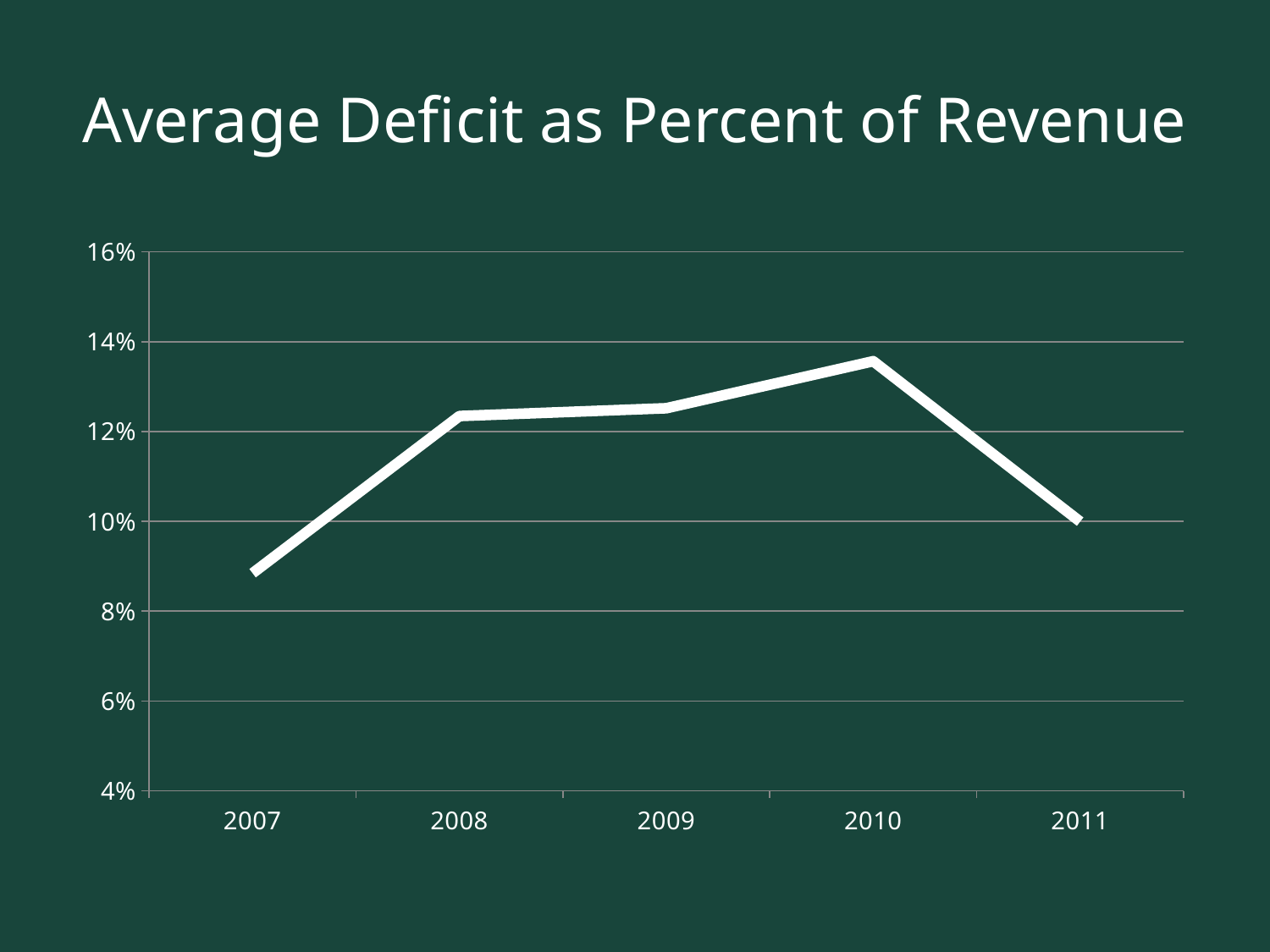
Which year has the highest average deficit as percent of revenue? 2010 How many years are plotted on the x axis? 5 What kind of chart is shown on the slide? Line chart Is the value for 2011 greater or less than 8%? greater Which year has the lowest average deficit as percent of revenue? 2007 Does the line rise or fall from 2010 to 2011? Fall What is the title of the chart? Average Deficit as Percent of Revenue Which is larger, the value for 2007 or the value for 2008? 2008 Is the value for 2008 greater or less than 12%? greater Which is larger, the value for 2010 or the value for 2011? 2010 Is the value for 2010 greater or less than 14%? less